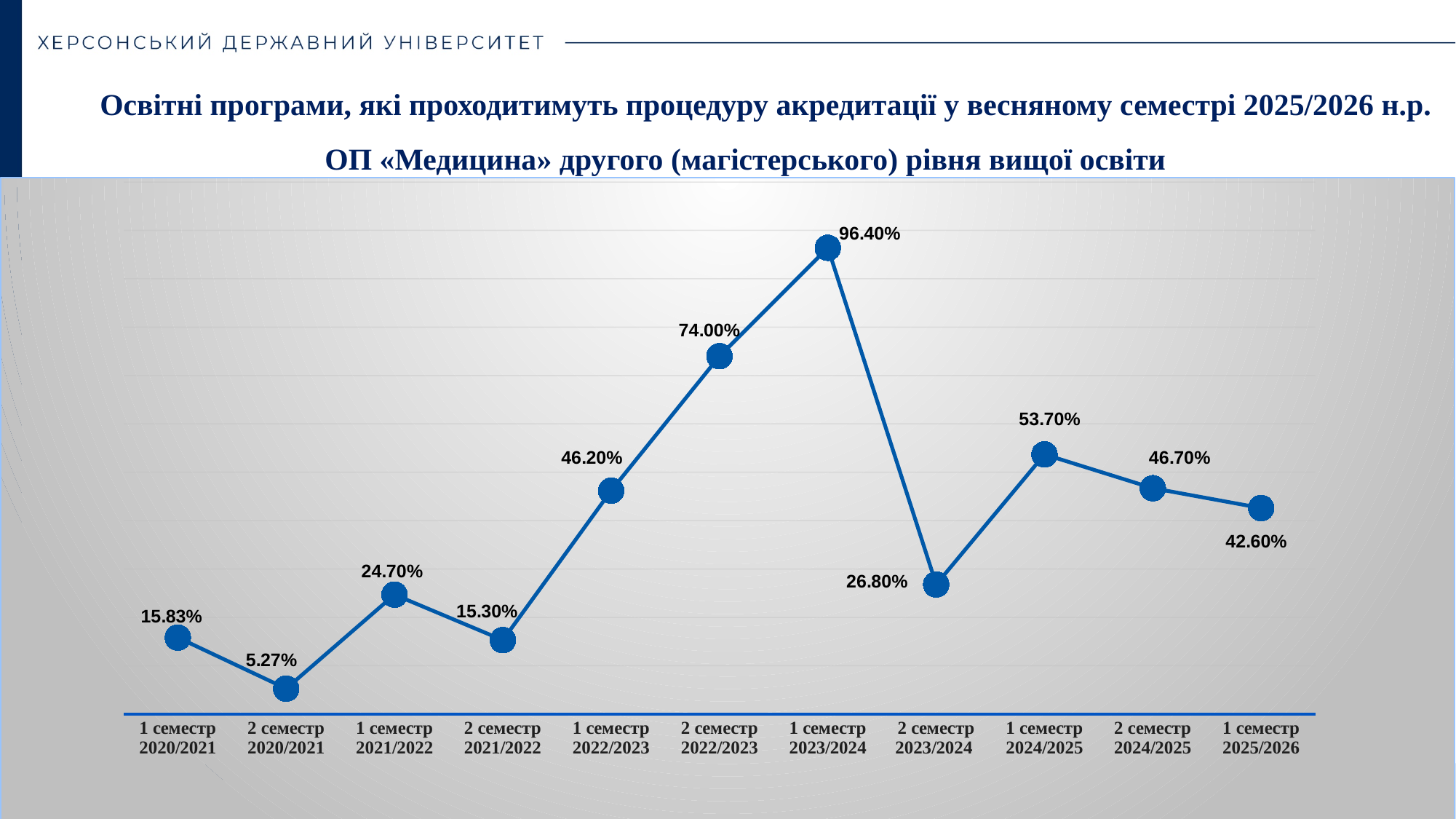
What is the difference between the values for 1 семестр 2023/2024 and 2 семестр 2022/2023? 22.40% Which semester has the highest value? 1 семестр 2023/2024 How many data points are plotted on the chart? 11 What is the value for 1 семестр 2025/2026? 42.60% What is the value for 2 семестр 2023/2024? 26.80% What is the difference between the values for 1 семестр 2024/2025 and 2 семестр 2024/2025? 7.00% Do the values rise or fall from 1 семестр 2024/2025 to 1 семестр 2025/2026? Fall What is the value for 2 семестр 2020/2021? 5.27% Which is larger, the value for 1 семестр 2021/2022 or the value for 2 семестр 2021/2022? 1 семестр 2021/2022 What kind of chart is shown on the slide? Line chart What is the value for 1 семестр 2023/2024? 96.40% Which semester has the lowest value? 2 семестр 2020/2021